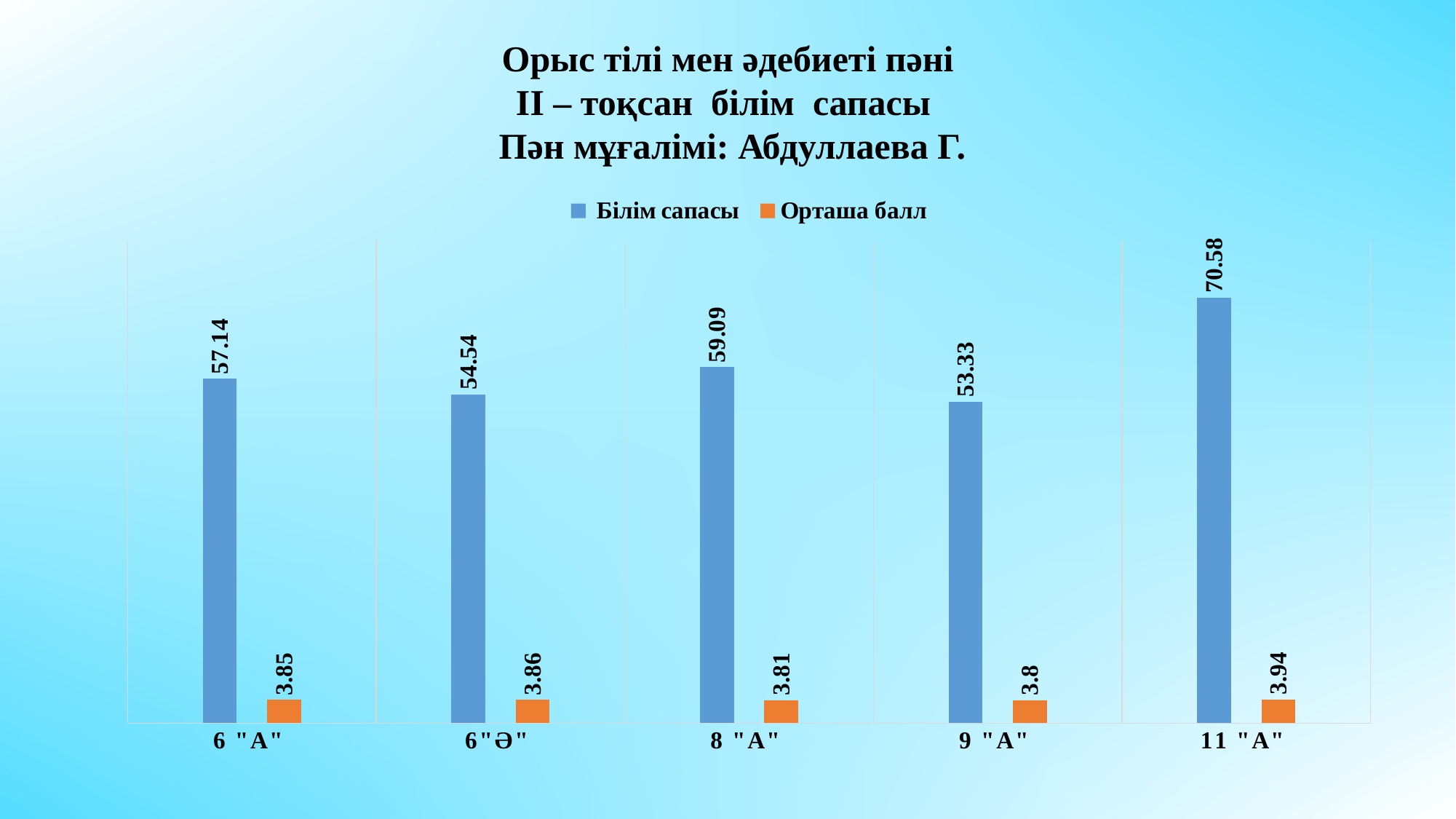
Which class has the highest Орташа балл value? 11 "А" What is the Білім сапасы value for 9 "А"? 53.33 What kind of chart is shown on the slide? Bar chart Which class has the highest Білім сапасы value? 11 "А" What is the Білім сапасы value for 11 "А"? 70.58 Which is larger, the Білім сапасы value for 6 "А" or for 6"Ә"? 6 "А" How many series does the legend list? 2 What is the Орташа балл value for 8 "А"? 3.81 Which class has the lowest Білім сапасы value? 9 "А" What is the difference between the Білім сапасы values for 11 "А" and 9 "А"? 17.25 How many classes are shown on the x axis? 5 What is the Орташа балл value for 6"Ә"? 3.86